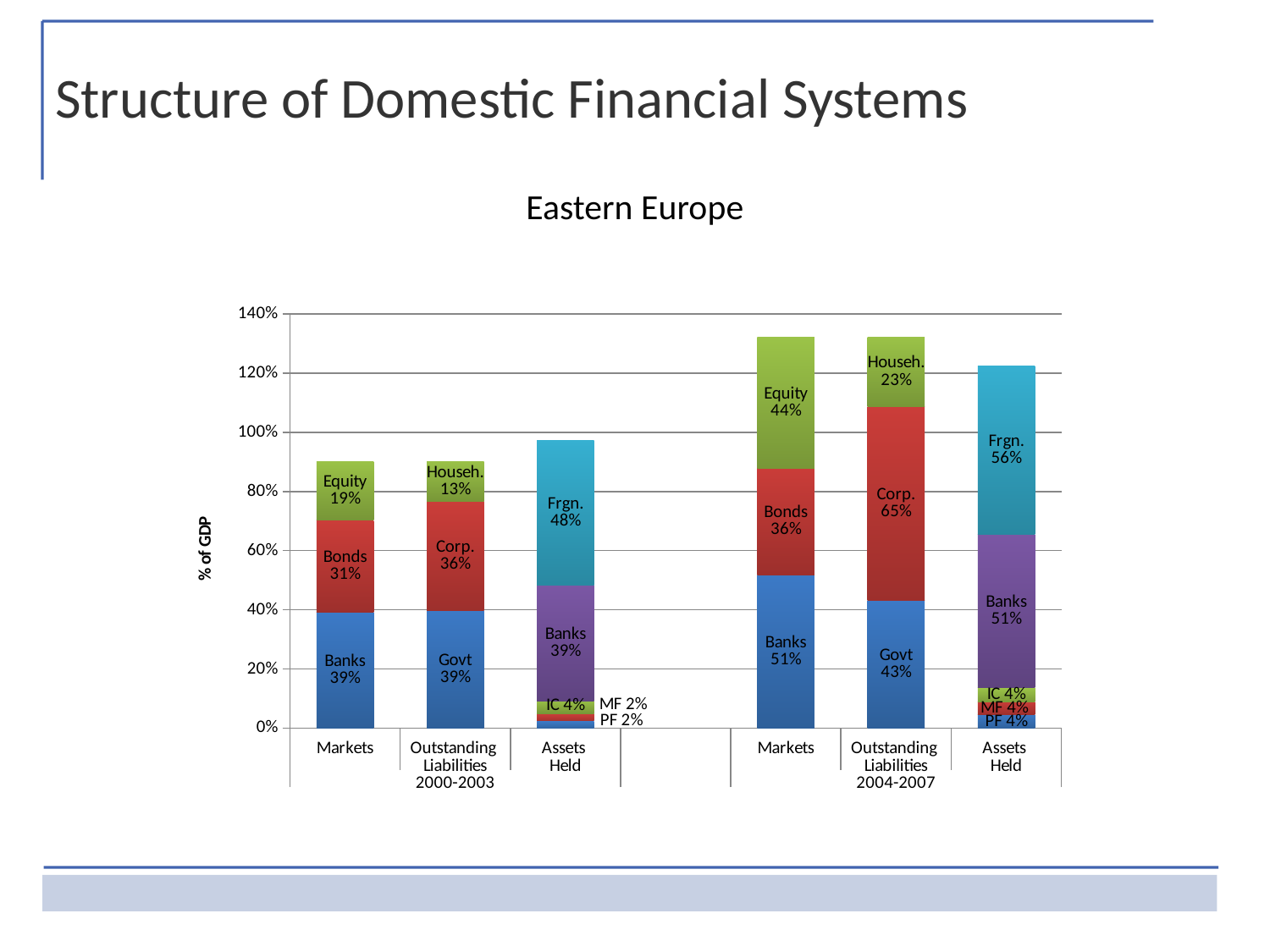
In the Eastern Europe chart, what is the Equity value in the Markets bar for 2004-2007? 44% In the Eastern Europe chart, what is the Corp. value in the Outstanding Liabilities bar for 2004-2007? 65% In the Eastern Europe chart, what is the Banks value in the Markets bar for 2000-2003? 39% In the Eastern Europe chart, which period has the larger Bonds value in the Markets bar, 2000-2003 or 2004-2007? 2004-2007 What kind of chart is shown on the slide? Stacked bar chart In the Eastern Europe chart, is the total height of the Assets Held bar for 2000-2003 greater or less than 100%? less How many stacked bars are plotted in the Eastern Europe chart? 6 In the Eastern Europe chart, is the total height of the Markets bar for 2004-2007 greater or less than 120%? greater In the Eastern Europe chart, what is the Househ. value in the Outstanding Liabilities bar for 2000-2003? 13% In the Eastern Europe chart, what is the Frgn. value in the Assets Held bar for 2000-2003? 48% In the Eastern Europe chart, by how many percentage points does the Govt value in Outstanding Liabilities for 2004-2007 exceed that for 2000-2003? 4 percentage points In the Eastern Europe chart, by how many percentage points does the Frgn. value in Assets Held for 2004-2007 exceed that for 2000-2003? 8 percentage points